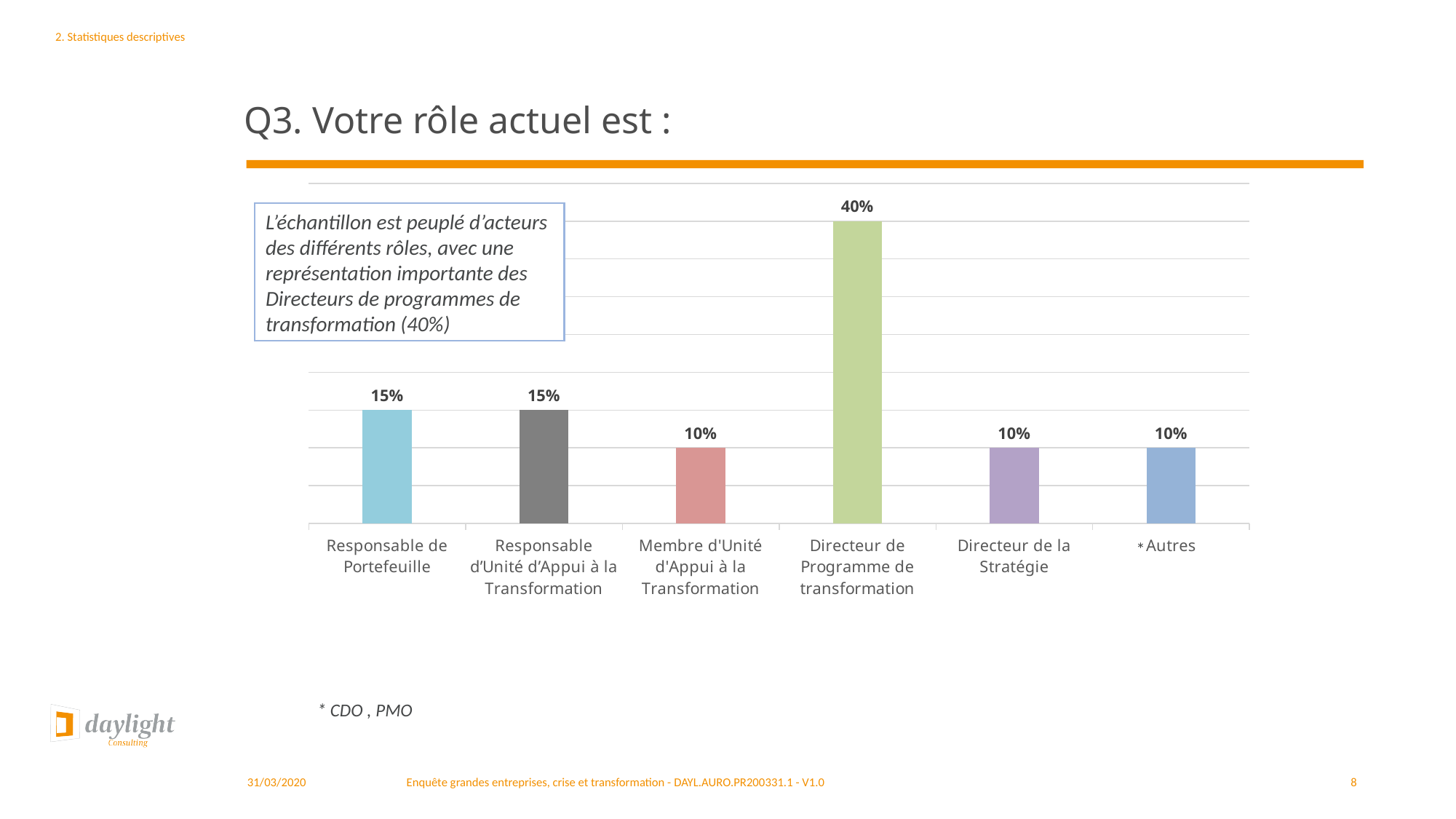
Which category has the highest value? Directeur de Programme de transformation What is the value for Responsable de Portefeuille? 15% Which is larger, Responsable de Portefeuille or Membre d'Unité d'Appui à la Transformation? Responsable de Portefeuille How many categories have a value of 10%? 3 What is the difference between Directeur de Programme de transformation and Responsable de Portefeuille? 25% What is the value for Autres? 10% What kind of chart is shown on the slide? Bar chart What is the title of the slide containing the chart? Q3. Votre rôle actuel est : How many categories are shown in the chart? 6 What is the value for Directeur de Programme de transformation? 40% What is the value for Directeur de la Stratégie? 10% What is the difference between Responsable d'Unité d'Appui à la Transformation and Membre d'Unité d'Appui à la Transformation? 5%